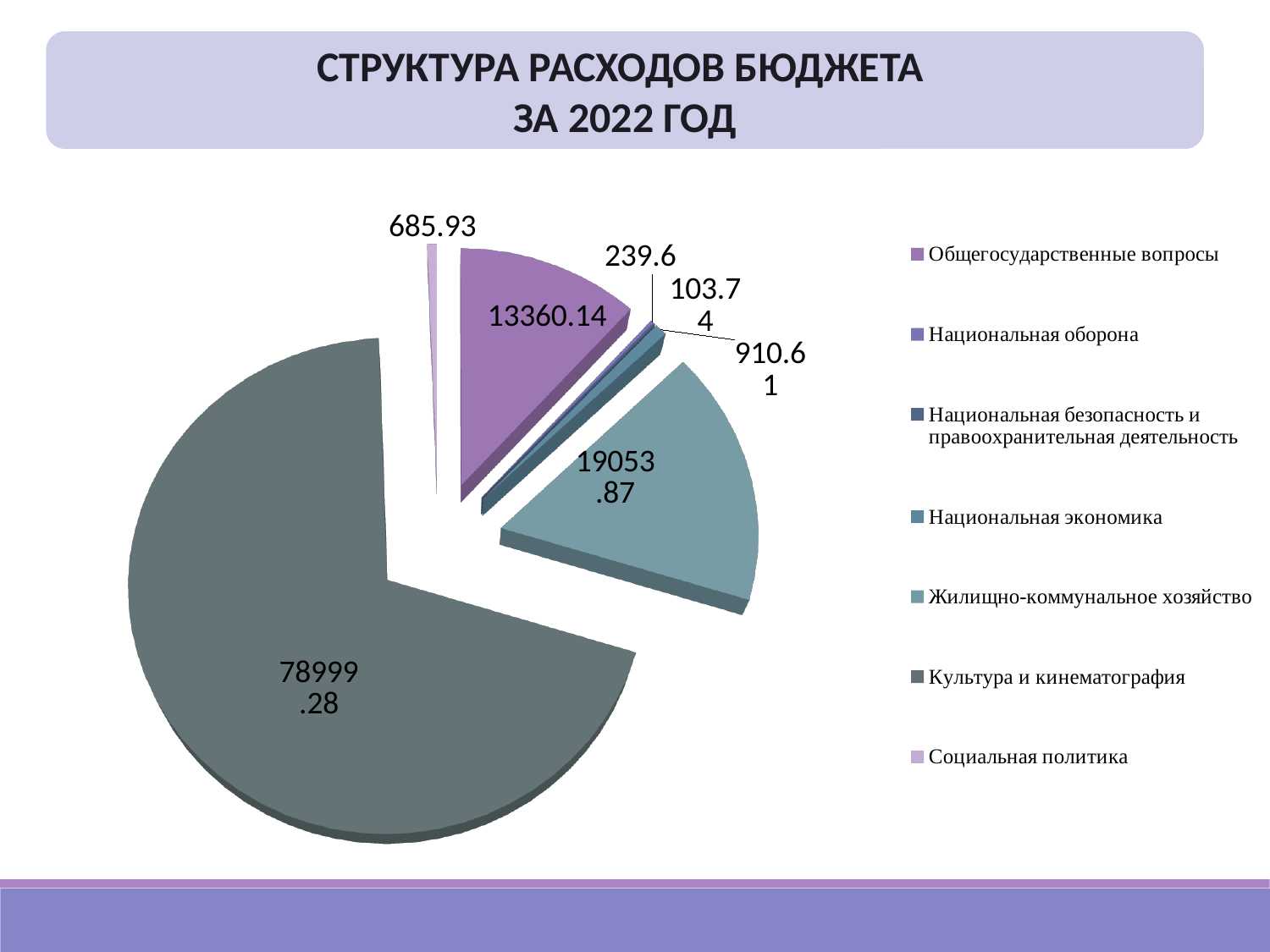
What is the value for Национальная безопасность и правоохранительная деятельность? 103.74 Which is larger: the value for Национальная экономика or the value for Социальная политика? Национальная экономика What type of chart is shown on the slide? Pie chart What is the difference between the values for Жилищно-коммунальное хозяйство and Общегосударственные вопросы? 5693.73 How many categories does the legend list? 7 What is the title of the chart on the slide? СТРУКТУРА РАСХОДОВ БЮДЖЕТА ЗА 2022 ГОД Which category has the smallest value? Национальная безопасность и правоохранительная деятельность What is the value for Культура и кинематография? 78999.28 Which category has the largest slice of the pie? Культура и кинематография What is the value for Общегосударственные вопросы? 13360.14 What is the value for Социальная политика? 685.93 What is the value for Жилищно-коммунальное хозяйство? 19053.87